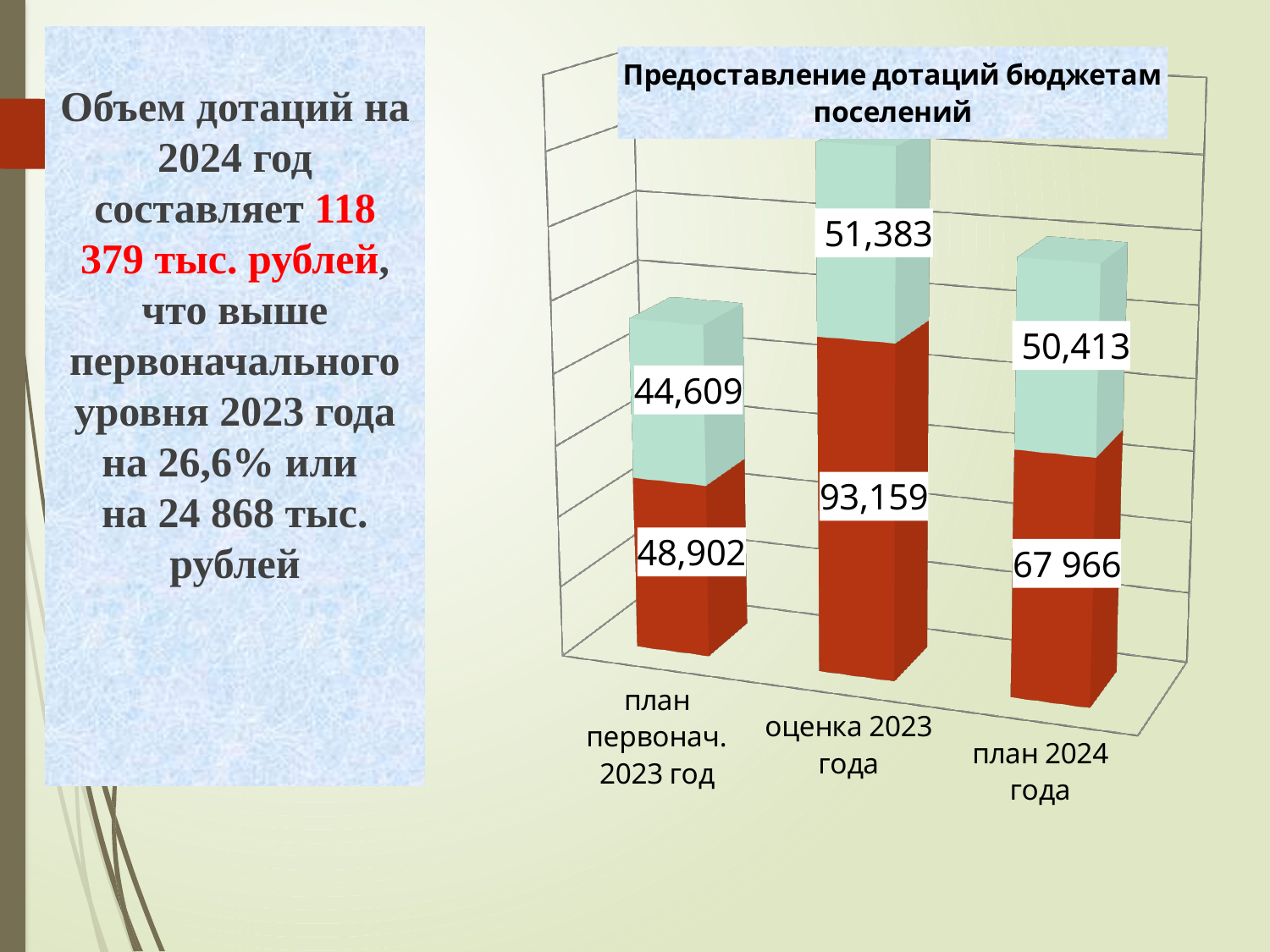
What is the title of the chart? Предоставление дотаций бюджетам поселений What is the value of the red segment for 'план 2024 года'? 67 966 Which is larger: the light green segment for 'оценка 2023 года' or for 'план первонач. 2023 год'? оценка 2023 года What is the value of the red segment for 'оценка 2023 года'? 93,159 What is the difference between the red segment values for 'оценка 2023 года' and 'план первонач. 2023 год'? 44,257 How many categories are shown on the x axis of the chart? 3 Which category has the lowest value for the light green segment? план первонач. 2023 год Which category has the highest value for the red segment? оценка 2023 года What kind of chart is shown on the slide? stacked bar chart What is the value of the light green segment for 'план первонач. 2023 год'? 44,609 What is the value of the light green segment for 'план 2024 года'? 50,413 What is the total of the stacked bar for 'план 2024 года'? 118 379